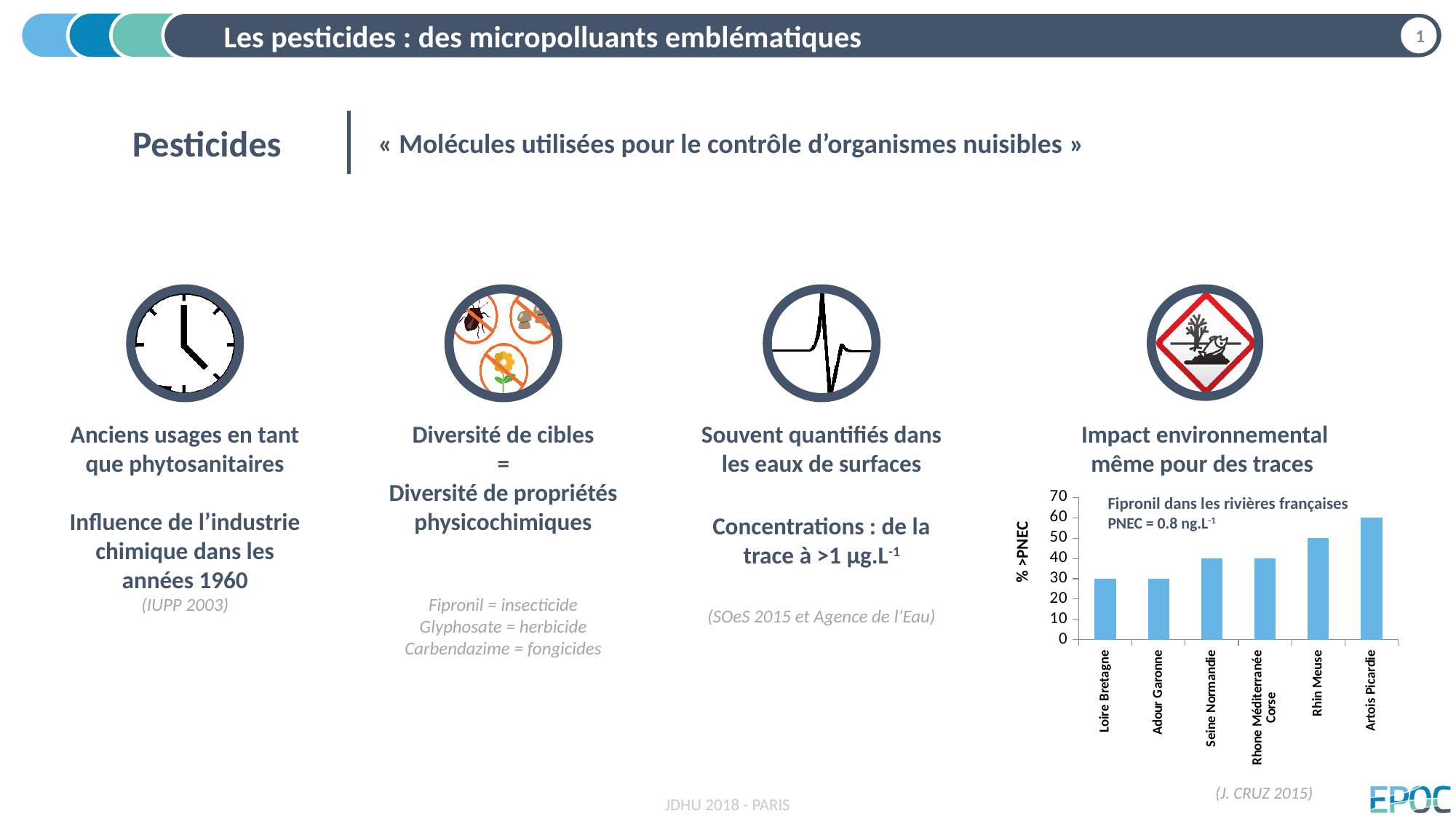
What is the % >PNEC value for Loire Bretagne? 30 Is the value for Adour Garonne greater or less than 40? less What is the label of the y axis of the bar chart? % >PNEC What PNEC value is stated in the bar chart's title text? 0.8 ng.L-1 What kind of chart is shown on the slide? bar chart Is the value for Rhin Meuse greater or less than 40? greater Which is larger, the value for Seine Normandie or the value for Adour Garonne? Seine Normandie How many river basins (categories) are shown in the bar chart? 6 Which river basin has the highest % >PNEC value in the bar chart? Artois Picardie What is the % >PNEC value for Artois Picardie? 60 What is the difference between the values for Artois Picardie and Loire Bretagne? 30 What is the % >PNEC value for Rhin Meuse? 50